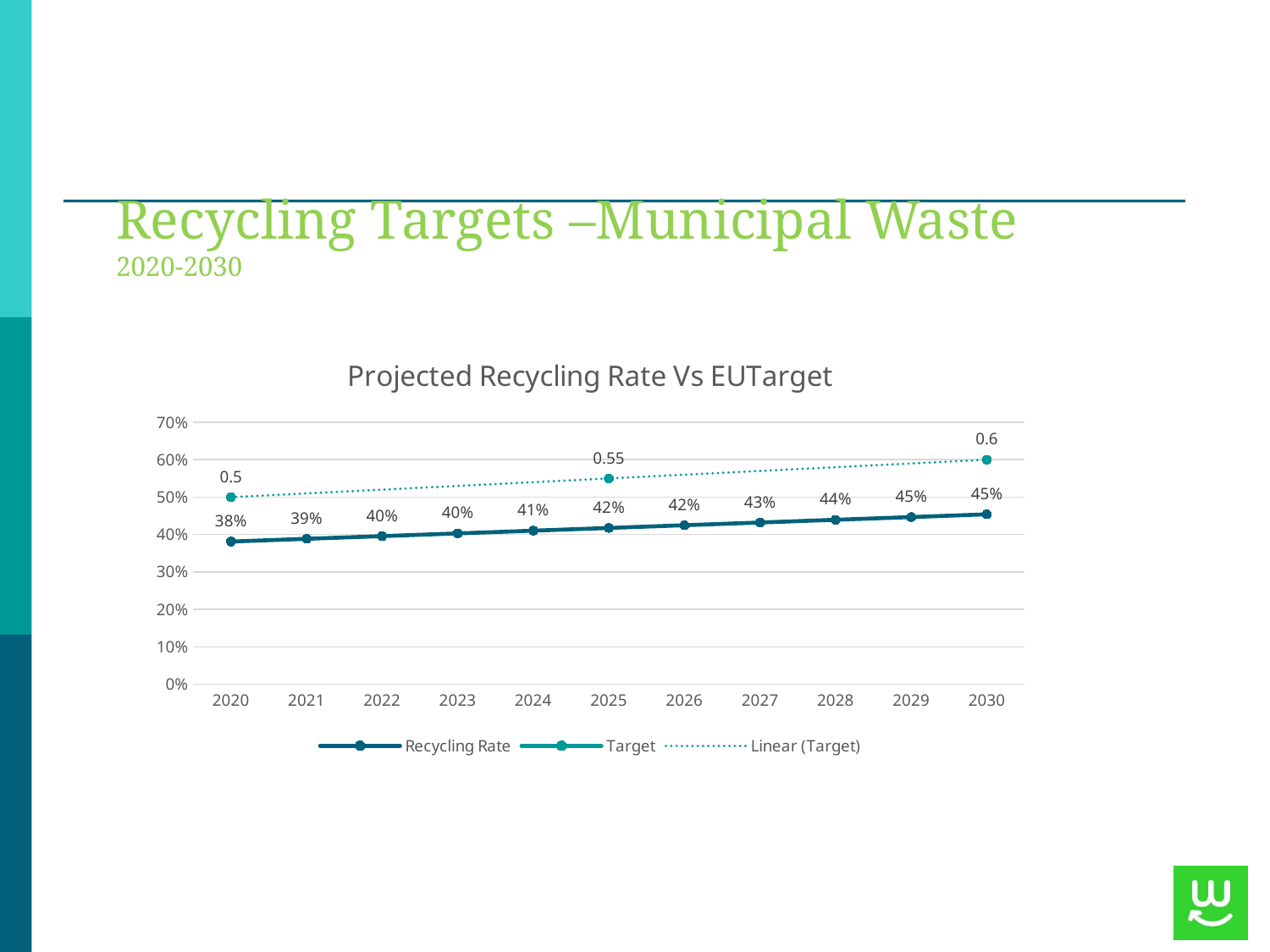
Which year has the lowest Recycling Rate? 2020 What is the difference between the Recycling Rate in 2030 and in 2020? 7% Does the Recycling Rate rise or fall from 2020 to 2030? rise What is the Target value shown for 2025? 0.55 Is the Recycling Rate for 2027 greater or less than 50%? less What is the Recycling Rate value for 2030? 45% How many series does the legend list? 3 What kind of chart is this? line chart Which is larger in 2024: the Recycling Rate or the Target line? Target What is the Recycling Rate value for 2020? 38% How many years are shown on the x axis? 11 What is the Target value shown for 2030? 0.6